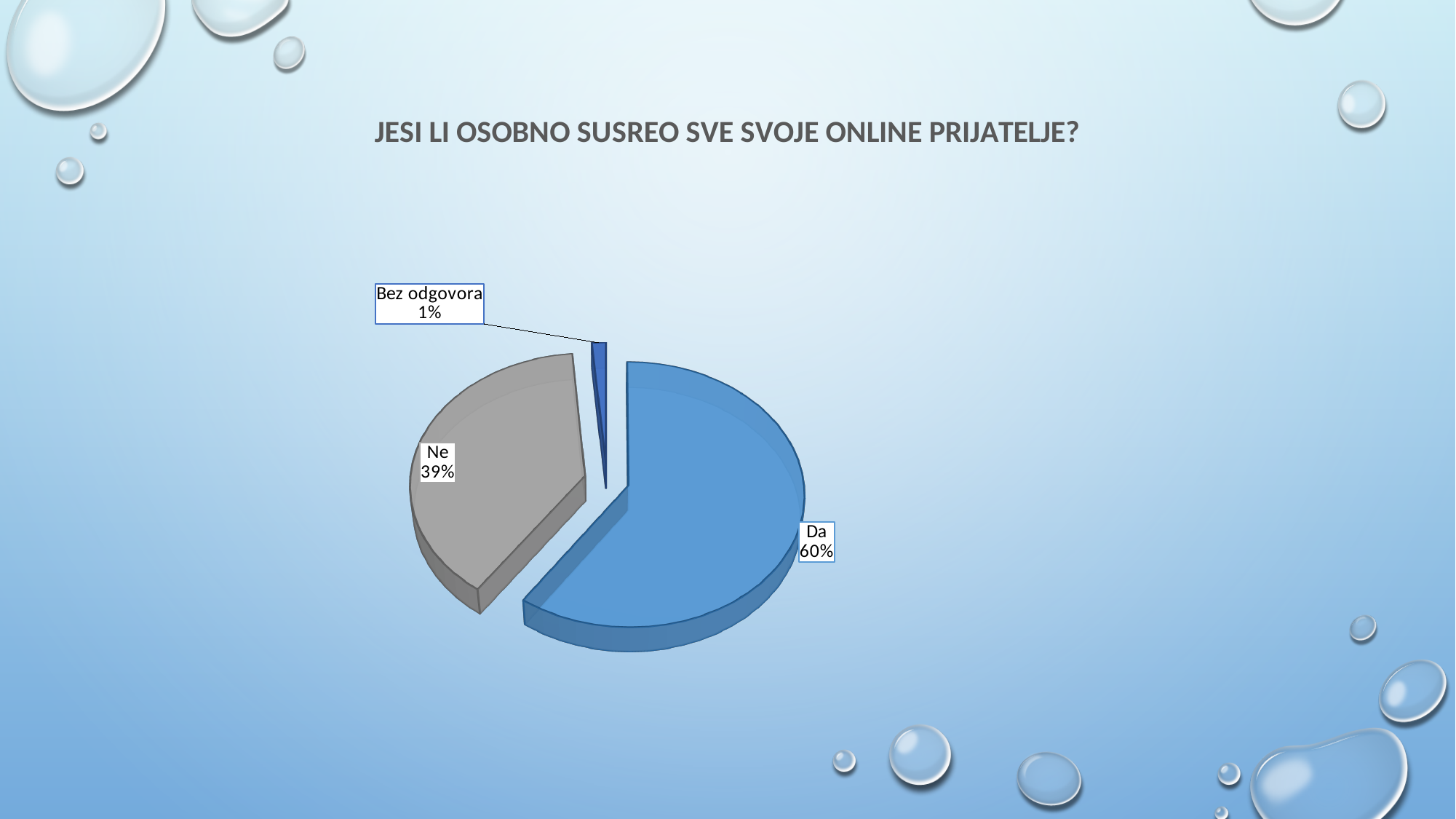
What share of the pie does "Bez odgovora" represent? 1% What share of the pie does "Da" represent? 60% What kind of chart is shown on the slide? Pie chart What is the difference in percentage points between "Da" and "Ne"? 21 What share of the pie does "Ne" represent? 39% Which is larger, the share for "Da" or the share for "Ne"? Da Which category has the largest slice of the pie? Da What is the title of the chart? JESI LI OSOBNO SUSREO SVE SVOJE ONLINE PRIJATELJE? Which category has the smallest slice of the pie? Bez odgovora What colour is the "Ne" slice of the pie? Grey How many categories are shown in the pie chart? 3 What is the difference in percentage points between "Ne" and "Bez odgovora"? 38